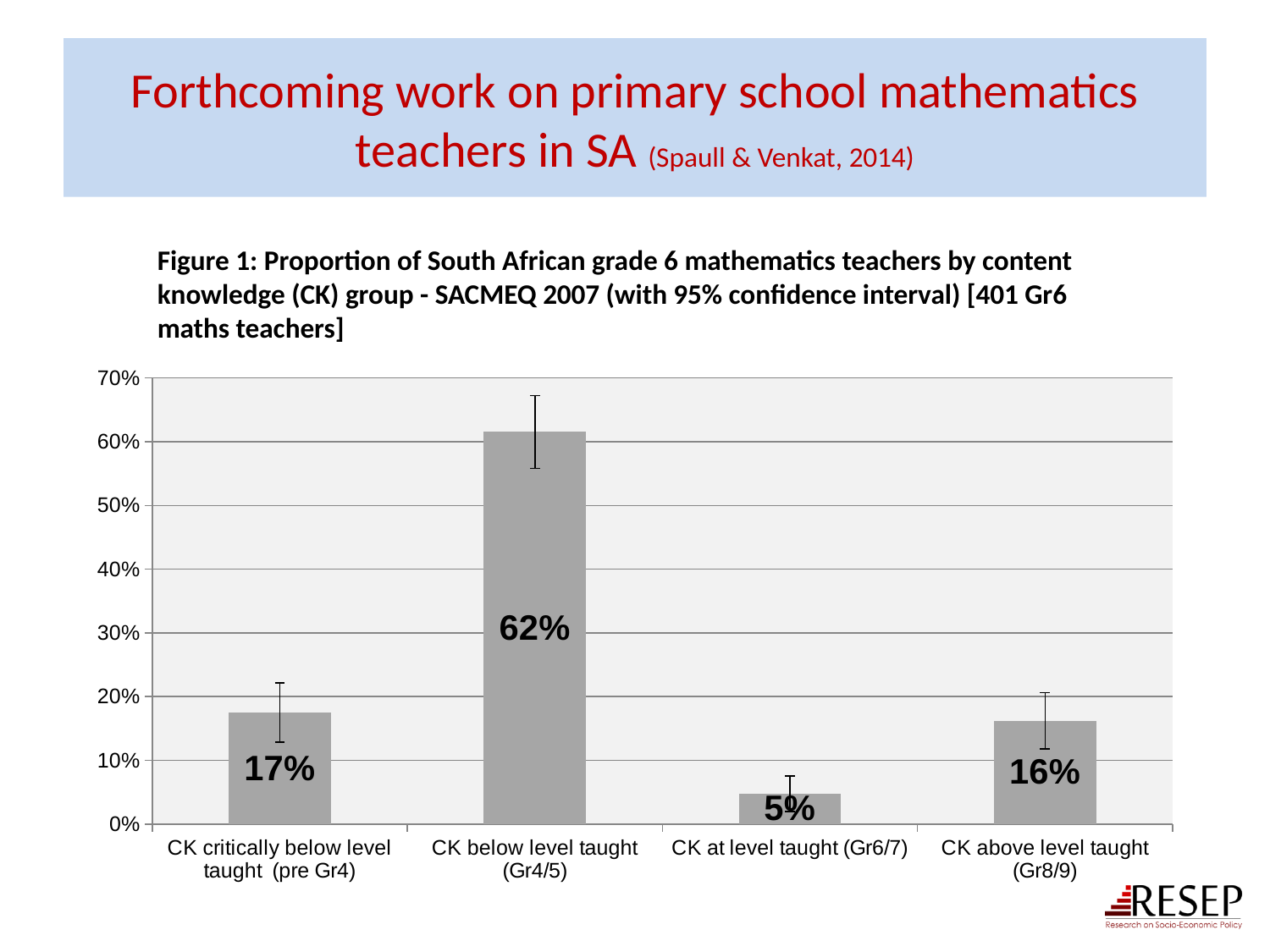
According to the figure title, how many grade 6 maths teachers are included in the data? 401 What is the value for CK above level taught (Gr8/9)? 16% How many categories are shown on the x axis? 4 Which is larger: the value for CK critically below level taught (pre Gr4) or CK at level taught (Gr6/7)? CK critically below level taught (pre Gr4) What is the value for CK critically below level taught (pre Gr4)? 17% What is the value for CK below level taught (Gr4/5)? 62% What kind of chart is shown on the slide? bar chart What is the difference between the values for CK below level taught (Gr4/5) and CK critically below level taught (pre Gr4)? 45% Is the value for CK below level taught (Gr4/5) greater or less than 50%? greater Which category has the lowest value? CK at level taught (Gr6/7) Which category has the highest value? CK below level taught (Gr4/5) What is the value for CK at level taught (Gr6/7)? 5%